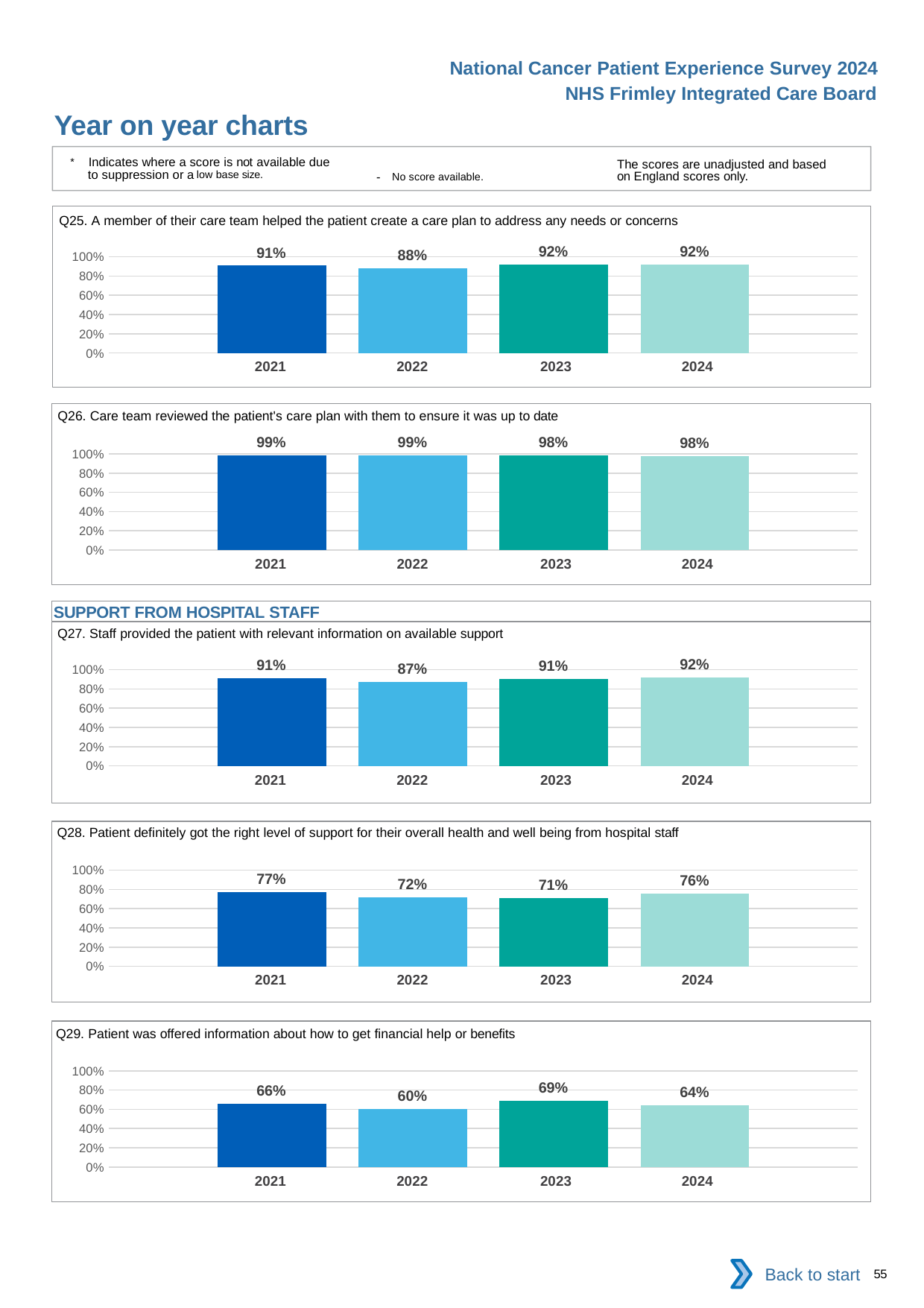
What kind of chart is the Q27 chart? bar chart In the Q26 chart, what is the value for 2024? 98% What is the section heading shown above the Q27 chart? SUPPORT FROM HOSPITAL STAFF In the Q28 chart, is the value for 2021 or 2024 larger? 2021 In the Q27 chart, which year has the lowest value? 2022 In the Q29 chart, is the value for 2022 greater or less than 80%? less In the Q29 chart, what is the difference between the 2023 and 2022 values? 9% In the Q26 chart, do the values rise or fall from 2021 to 2024? fall In the Q28 chart, which year has the highest value? 2021 In the Q25 chart, what is the value for 2022? 88% In the Q29 chart, which year has the highest value? 2023 How many years are shown in the Q25 chart? 4